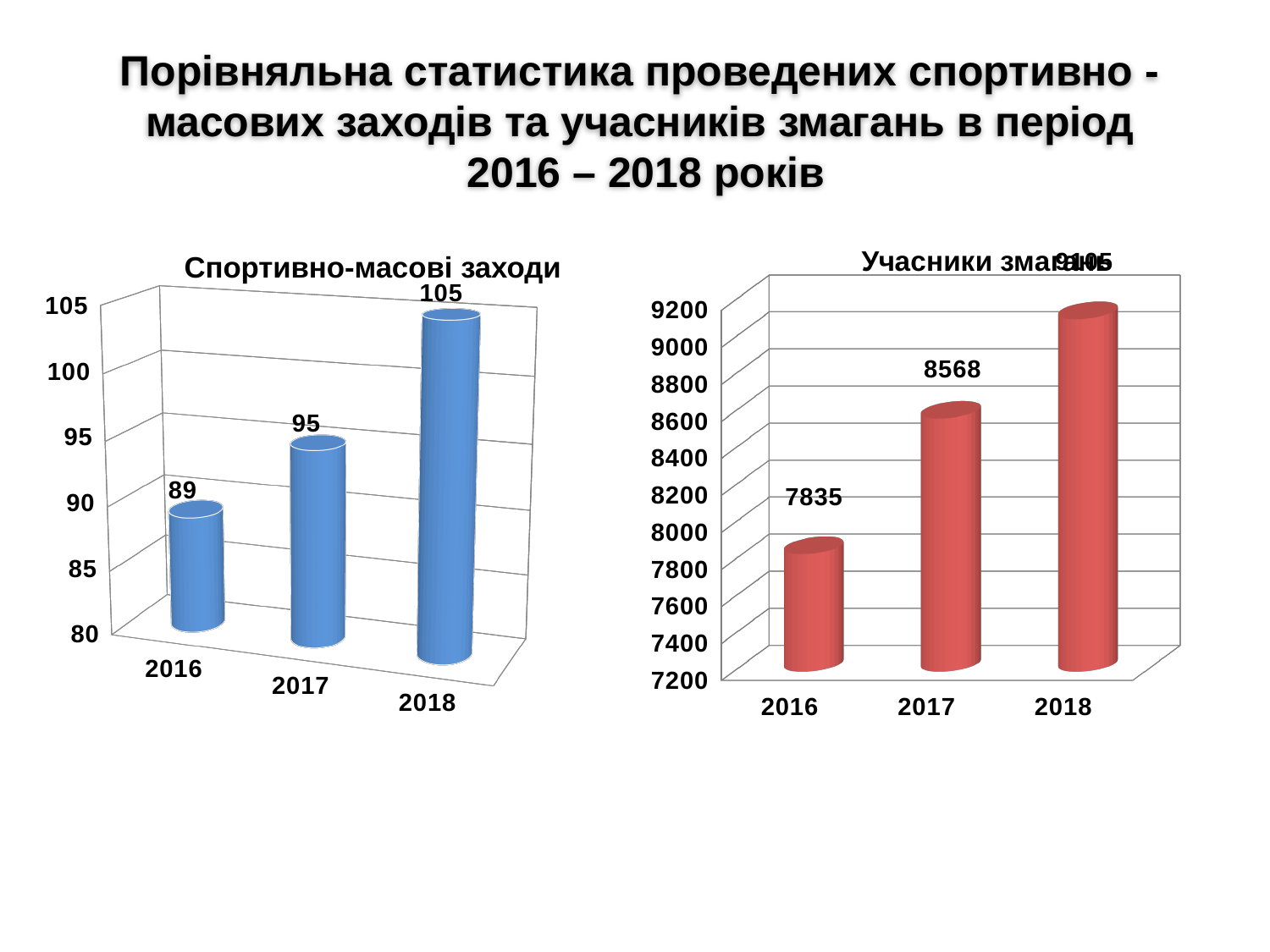
In the chart titled "Спортивно-масові заходи", which year has the highest value? 2018 In the chart on the right (Учасники змагань), what is the difference between the values for 2017 and 2016? 733 What kind of chart is the chart on the left (Спортивно-масові заходи)? bar chart In the chart on the right (Учасники змагань), what is the value for 2017? 8568 In the chart on the right (Учасники змагань), is the value for 2018 greater or less than 9000? greater In the chart titled "Спортивно-масові заходи", what is the value for 2016? 89 In the chart titled "Спортивно-масові заходи", what is the value for 2017? 95 In the chart on the right (Учасники змагань), which year has the lowest value? 2016 In the chart on the right (Учасники змагань), what is the value for 2016? 7835 In the chart titled "Спортивно-масові заходи", how many years are shown on the x axis? 3 In the chart titled "Спортивно-масові заходи", what is the difference between the values for 2018 and 2016? 16 In the chart titled "Спортивно-масові заходи", do the values rise or fall from 2016 to 2018? rise